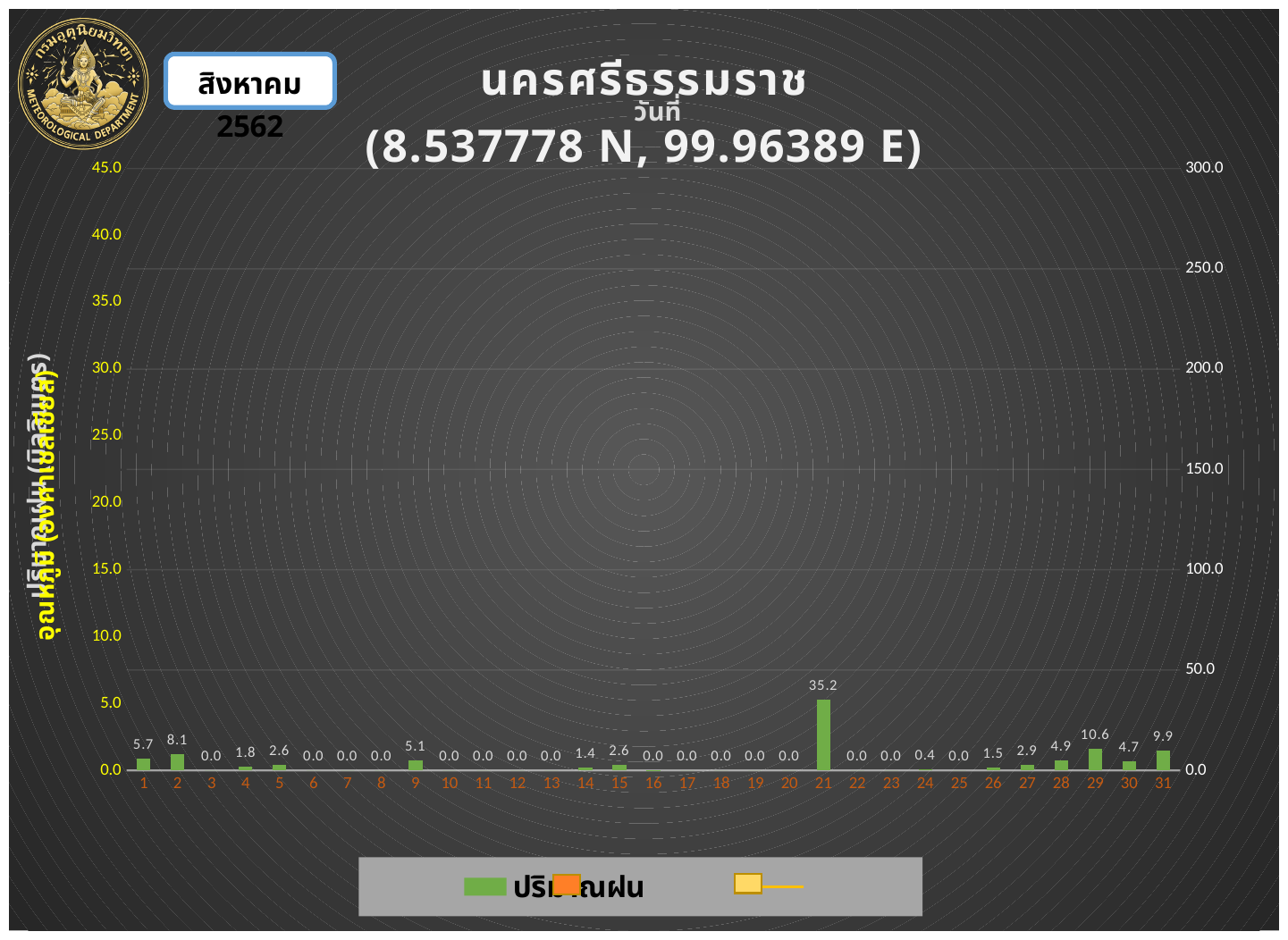
What is the difference between the values for day 31 and day 30? 5.2 What is the value shown for day 2? 8.1 What is the rainfall value shown for day 21? 35.2 Which is larger, the value for day 28 or the value for day 27? day 28 Which is larger, the value for day 1 or the value for day 9? day 1 What is the difference between the values for day 21 and day 29? 24.6 Which day has the highest rainfall value? 21 What is the value shown for day 29? 10.6 What is the value shown for day 24? 0.4 What month and year are shown in the box at the top left of the slide? สิงหาคม 2562 How many days are shown on the x axis? 31 What kind of chart is shown on the slide? bar chart